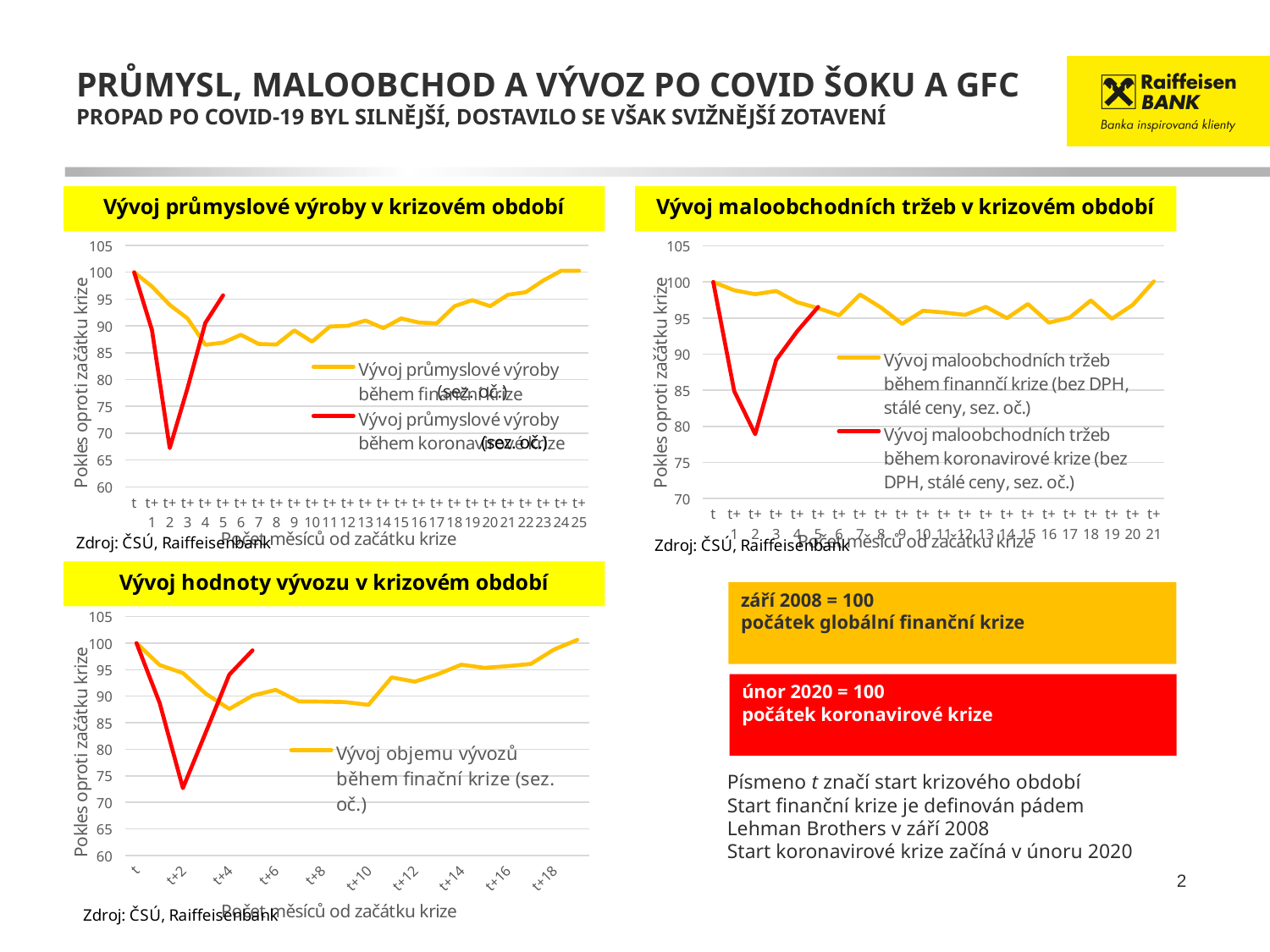
In 'Vývoj maloobchodních tržeb v krizovém období', does the yellow financial-crisis line ever fall below 90? no What kind of chart is 'Vývoj průmyslové výroby v krizovém období'? line chart In 'Vývoj hodnoty vývozu v krizovém období', is the lowest value of the red line greater or less than 75? less What colour is the line for the coronavirus crisis in the charts on the slide? red In 'Vývoj průmyslové výroby v krizovém období', is the lowest value of the red coronavirus-crisis line greater or less than 70? less In 'Vývoj průmyslové výroby v krizovém období', which series drops to a lower minimum, the financial-crisis line or the coronavirus-crisis line? the coronavirus-crisis line How many series does the legend of 'Vývoj maloobchodních tržeb v krizovém období' list? 2 How many series does the legend of 'Vývoj průmyslové výroby v krizovém období' list? 2 In 'Vývoj hodnoty vývozu v krizovém období', does the yellow line rise or fall between t+10 and t+18? rise In 'Vývoj průmyslové výroby v krizovém období', what is the last label on the x axis? t+25